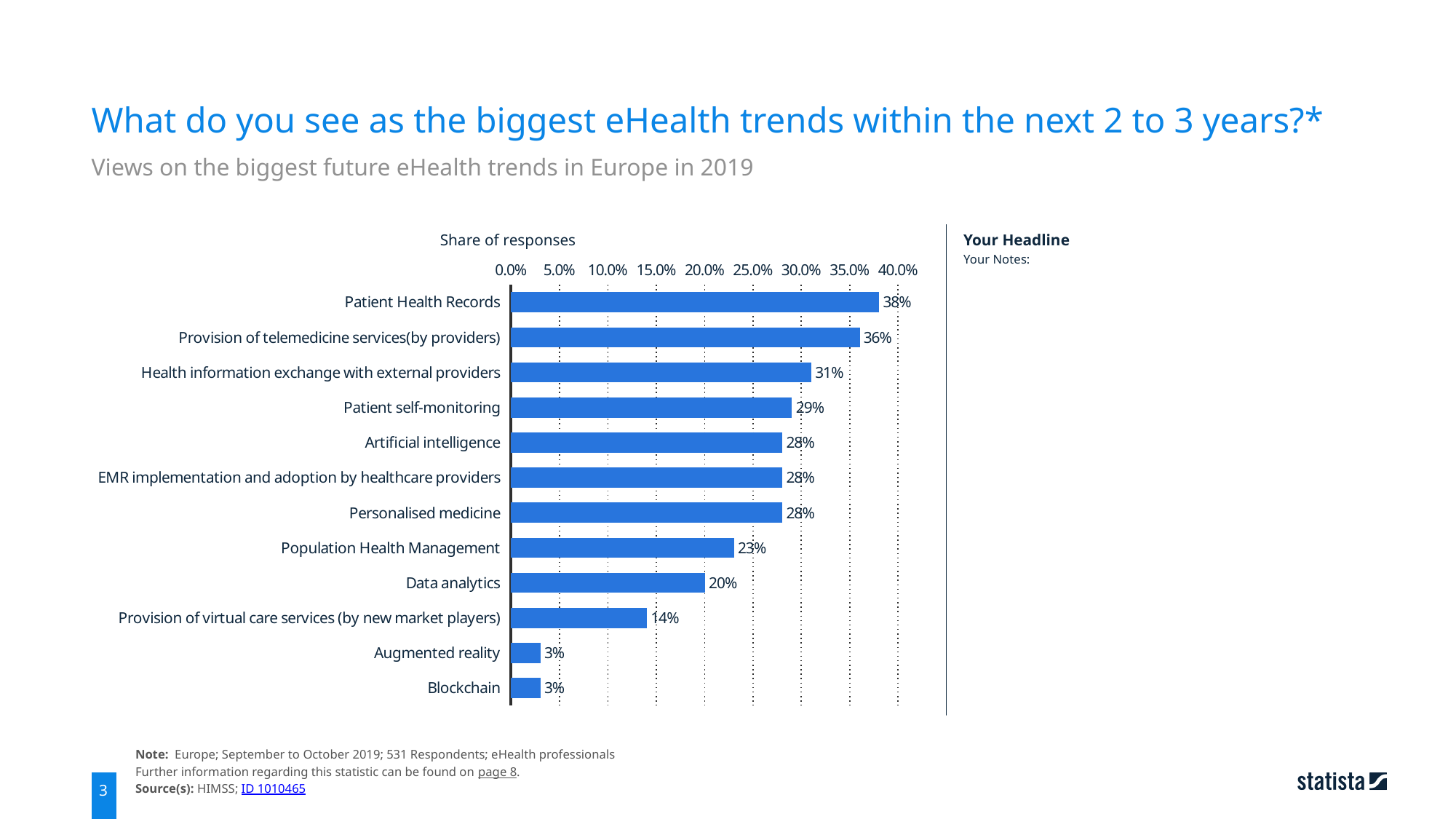
Which category has the highest share of responses? Patient Health Records What is the share of responses for Patient Health Records? 38% How many categories are shown in the chart? 12 What is the difference in share of responses between Health information exchange with external providers and Population Health Management? 8% What is the label of the value axis of the chart? Share of responses What is the share of responses for Data analytics? 20% What is the share of responses for Blockchain? 3% What is the difference in share of responses between Patient Health Records and Provision of telemedicine services(by providers)? 2% Is the share of responses for Population Health Management greater or less than 25.0%? less What is the share of responses for Provision of virtual care services (by new market players)? 14% What kind of chart is shown on the slide? bar chart Which has a larger share of responses, Patient self-monitoring or Data analytics? Patient self-monitoring